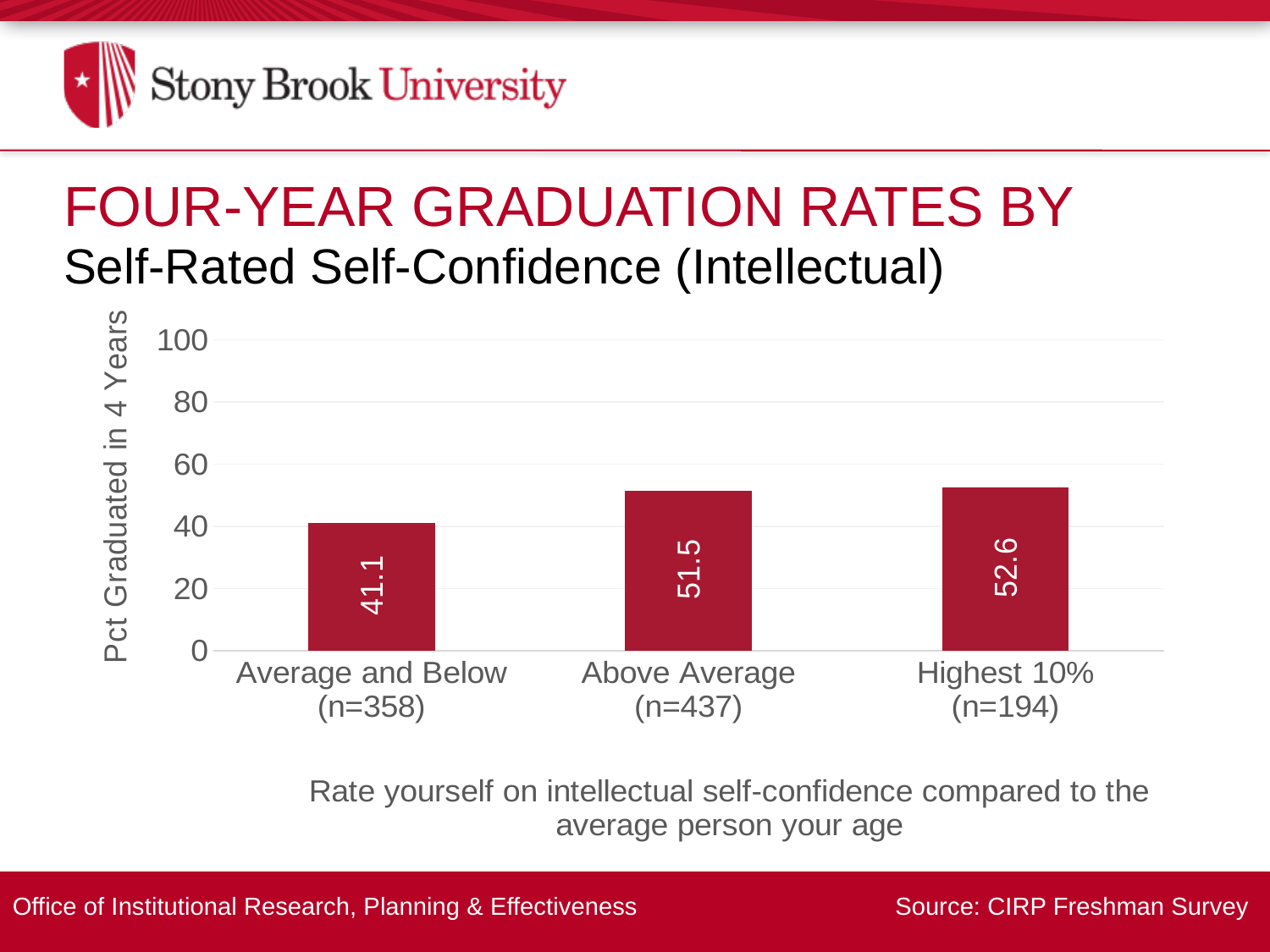
What is the difference in graduation rate between the Above Average group and the Average and Below group? 10.4 What is the difference in graduation rate between the Highest 10% group and the Average and Below group? 11.5 What kind of chart is shown on the slide? bar chart What is the label of the y axis? Pct Graduated in 4 Years Which self-confidence group has the lowest four-year graduation rate? Average and Below What is the four-year graduation rate for the Above Average group? 51.5 What is the four-year graduation rate for the Highest 10% group? 52.6 How many self-confidence groups are shown in the chart? 3 Is the graduation rate for the Above Average group greater or less than 60? less Which self-confidence group has the highest four-year graduation rate? Highest 10% Which group has a higher graduation rate, Above Average or Average and Below? Above Average What is the four-year graduation rate for the Average and Below group? 41.1